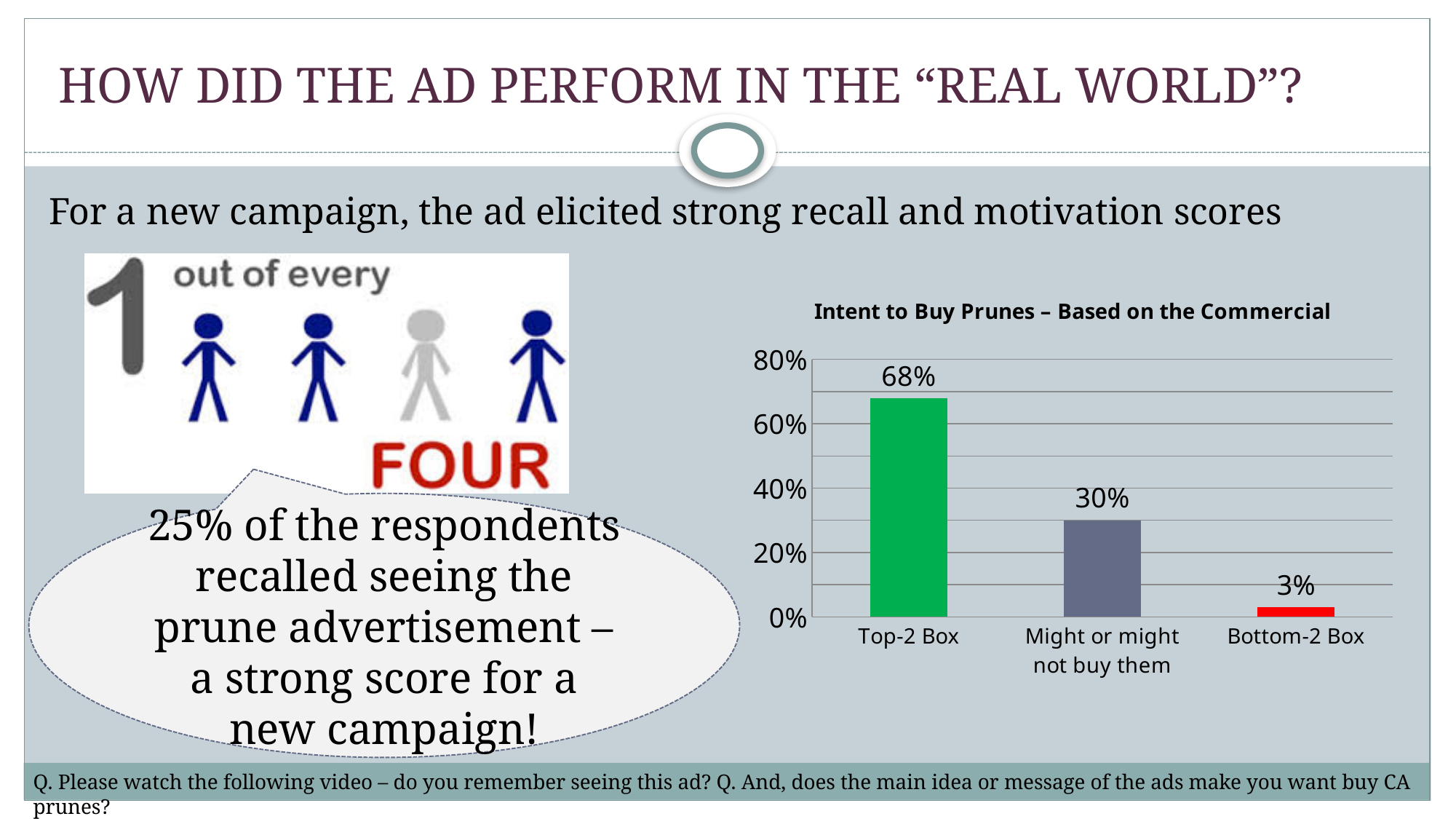
What is the difference between the Top-2 Box and Might or might not buy them values? 38% What is the title of the chart? Intent to Buy Prunes – Based on the Commercial How many categories are shown in the chart? 3 What is the value for Might or might not buy them? 30% Is the value for Top-2 Box greater or less than 60%? greater What is the difference between the Might or might not buy them and Bottom-2 Box values? 27% What kind of chart is shown on the slide? Bar chart What is the value for Top-2 Box in the Intent to Buy Prunes chart? 68% Which is larger, Top-2 Box or Bottom-2 Box? Top-2 Box Which category has the lowest value? Bottom-2 Box What is the value for Bottom-2 Box? 3% Which category has the highest value? Top-2 Box